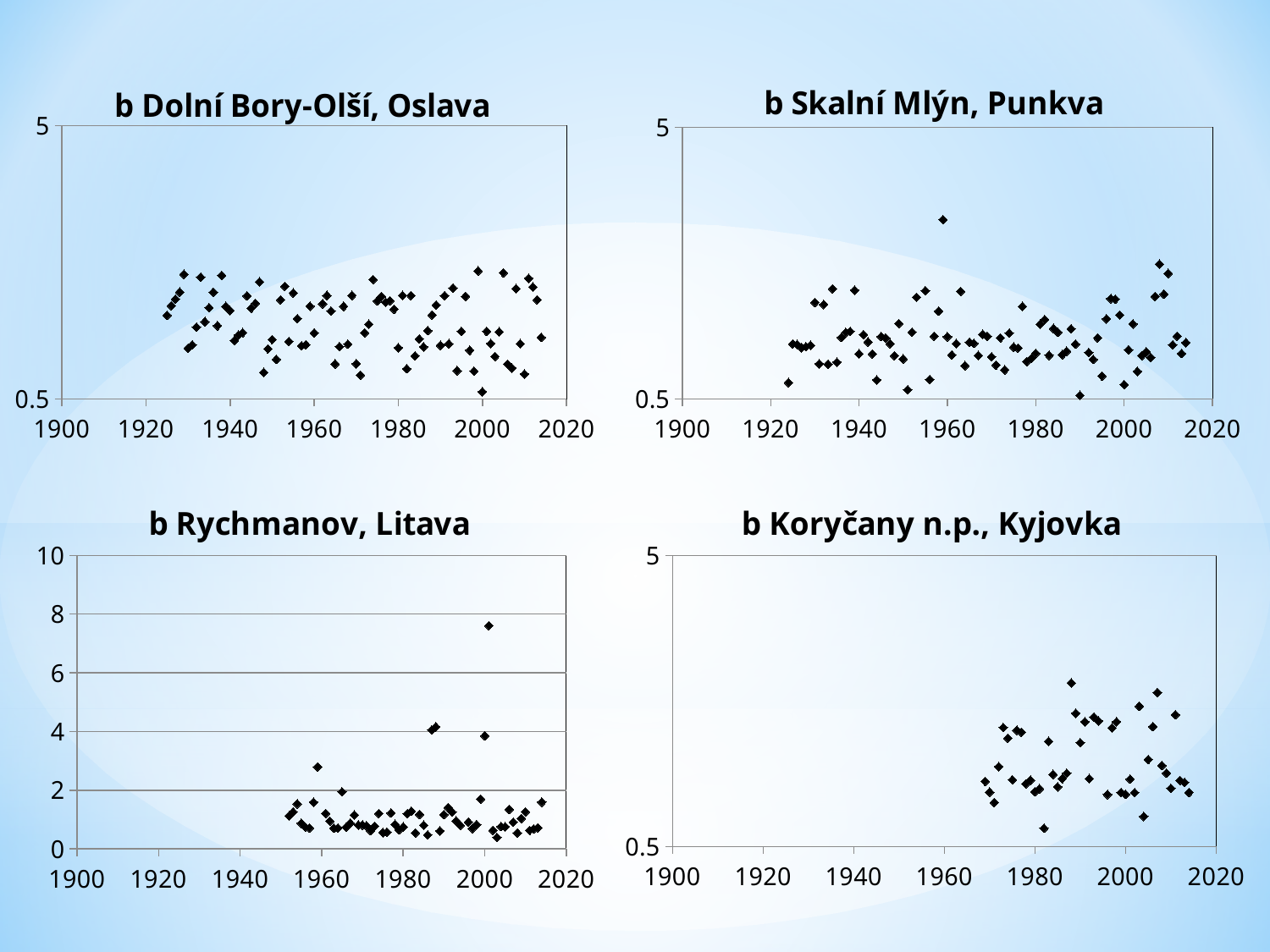
In the b Skalní Mlýn, Punkva chart, is the highest plotted value greater or less than 5? less In the b Rychmanov, Litava chart, do the plotted points begin before or after 1940 on the x axis? after What kind of chart is the b Dolní Bory-Olší, Oslava chart? scatter chart In the b Koryčany n.p., Kyjovka chart, do the plotted points begin before or after 1960 on the x axis? after What is the title of the top-left chart? b Dolní Bory-Olší, Oslava What kind of chart is the b Koryčany n.p., Kyjovka chart? scatter chart How many charts are shown on the slide? 4 Which chart on the slide has a y axis that goes up to 10? b Rychmanov, Litava